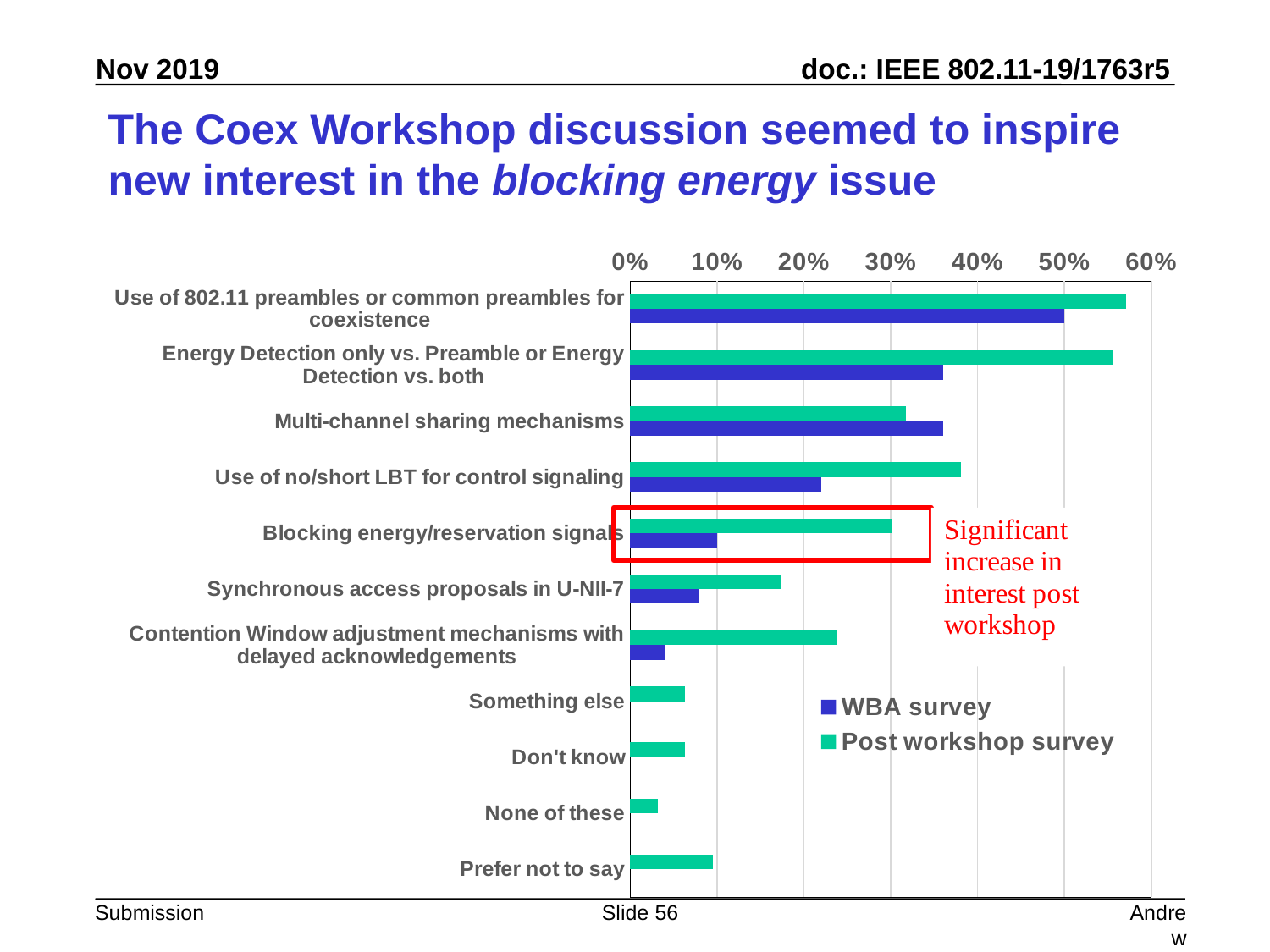
Is the WBA survey value for Blocking energy/reservation signals greater or less than 20%? less How many series does the chart legend list? 2 Is the WBA survey value for Contention Window adjustment mechanisms with delayed acknowledgements greater or less than 10%? less Which category is highlighted with a red box on the chart? Blocking energy/reservation signals How many categories are shown on the chart? 11 For Synchronous access proposals in U-NII-7, which series has the larger value, WBA survey or Post workshop survey? Post workshop survey Is the Post workshop survey value for Energy Detection only vs. Preamble or Energy Detection vs. both greater or less than 50%? greater Which category has the highest value in the WBA survey series? Use of 802.11 preambles or common preambles for coexistence Which colour represents the Post workshop survey series in the chart? green What kind of chart is shown on the slide? bar chart For Use of no/short LBT for control signaling, which series has the larger value, WBA survey or Post workshop survey? Post workshop survey